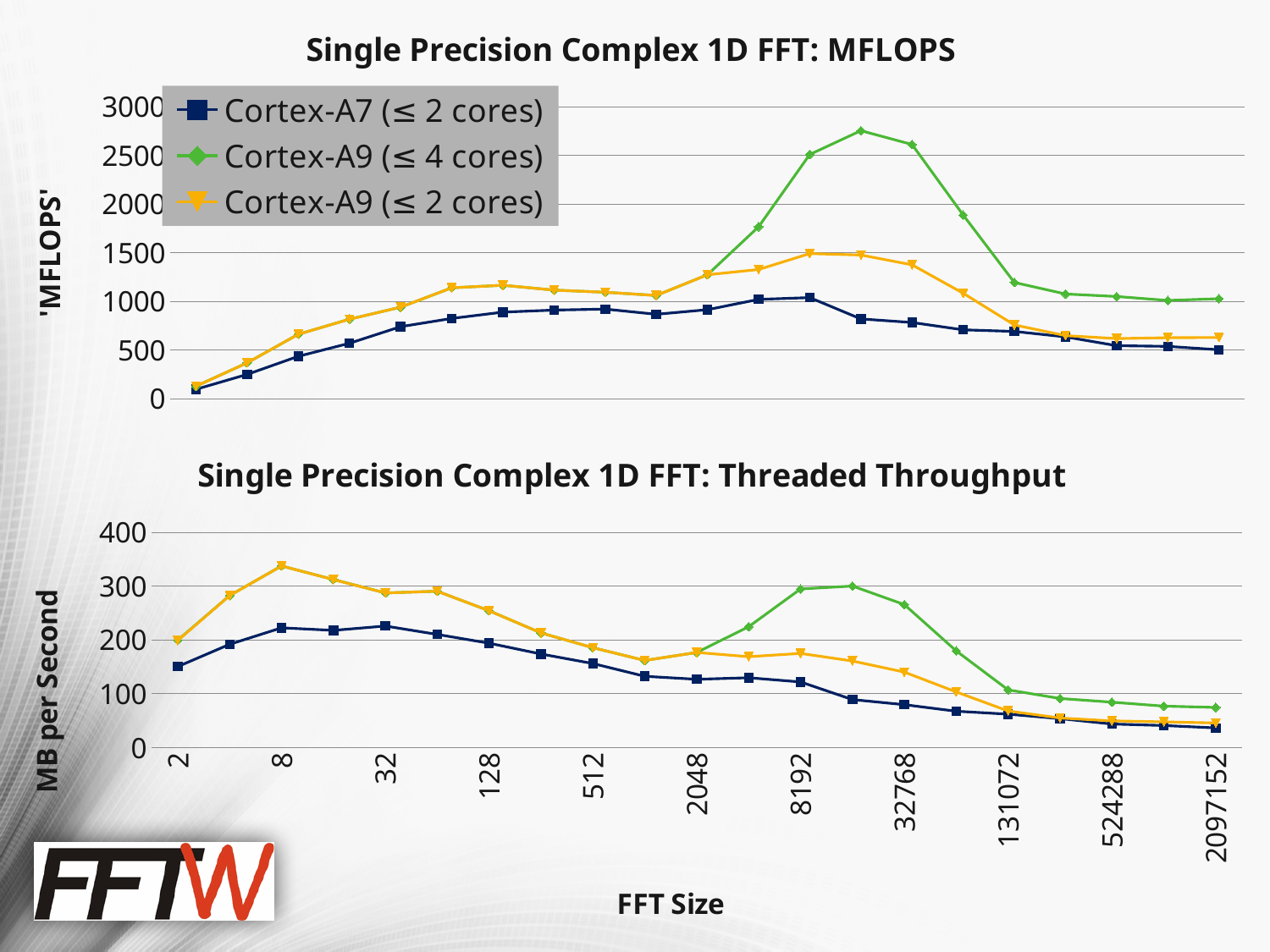
What is the y-axis label of the bottom chart (Threaded Throughput)? MB per Second In the top chart (MFLOPS), is the value for Cortex-A9 (≤ 4 cores) at FFT size 32768 greater or less than 2000? greater What kind of chart is the top chart titled 'Single Precision Complex 1D FFT: MFLOPS'? line chart In the bottom chart (Threaded Throughput), does the Cortex-A7 (≤ 2 cores) line rise or fall from FFT size 32 to 2097152? fall In the bottom chart (Threaded Throughput), is the value for Cortex-A9 (≤ 2 cores) at FFT size 8 greater or less than 300? greater What is the x-axis title shared by the charts? FFT Size In the top chart (MFLOPS), which series reaches the highest value? Cortex-A9 (≤ 4 cores) How many series does the legend of the top chart list? 3 In the top chart (MFLOPS), at FFT size 8192, which series has the larger value: Cortex-A9 (≤ 4 cores) or Cortex-A7 (≤ 2 cores)? Cortex-A9 (≤ 4 cores) In the bottom chart (Threaded Throughput), is the value for Cortex-A7 (≤ 2 cores) at FFT size 2097152 greater or less than 100? less